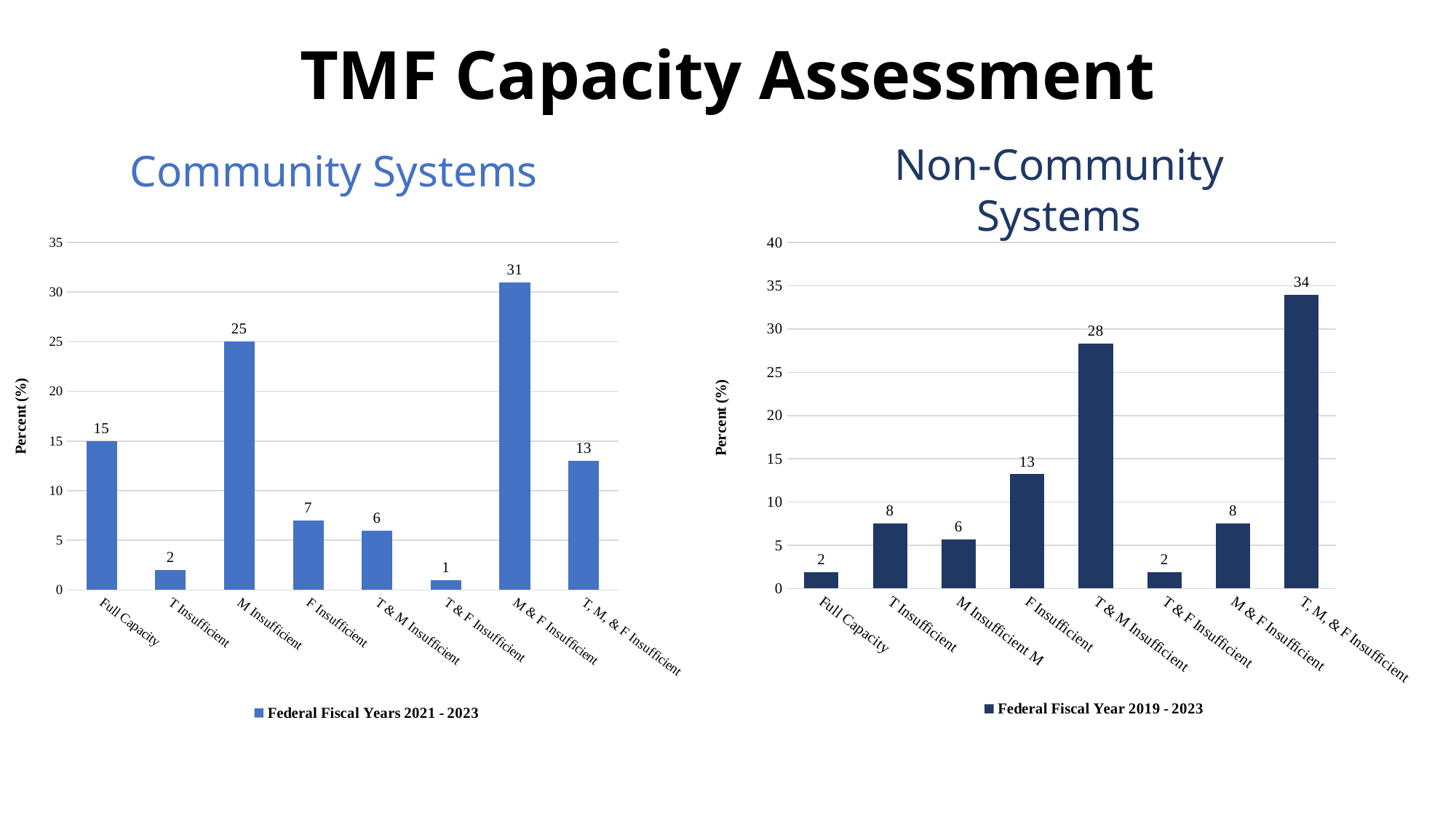
What kind of chart is the Community Systems chart? bar chart In the Community Systems chart, what is the value for M Insufficient? 25 In the Community Systems chart, is the value for M & F Insufficient greater or less than 30? greater In the Non-Community Systems chart, which is larger, Full Capacity or T Insufficient? T Insufficient In the Non-Community Systems chart, which category has the highest value? T, M, & F Insufficient In the Non-Community Systems chart, what is the value for T & M Insufficient? 28 In the Community Systems chart, what is the difference between M & F Insufficient and Full Capacity? 16 What is the legend entry for the Non-Community Systems chart? Federal Fiscal Year 2019 - 2023 In the Community Systems chart, which category has the highest value? M & F Insufficient In the Community Systems chart, which category has the lowest value? T & F Insufficient In the Non-Community Systems chart, what is the difference between T, M, & F Insufficient and F Insufficient? 21 How many categories are shown in the Non-Community Systems chart? 8